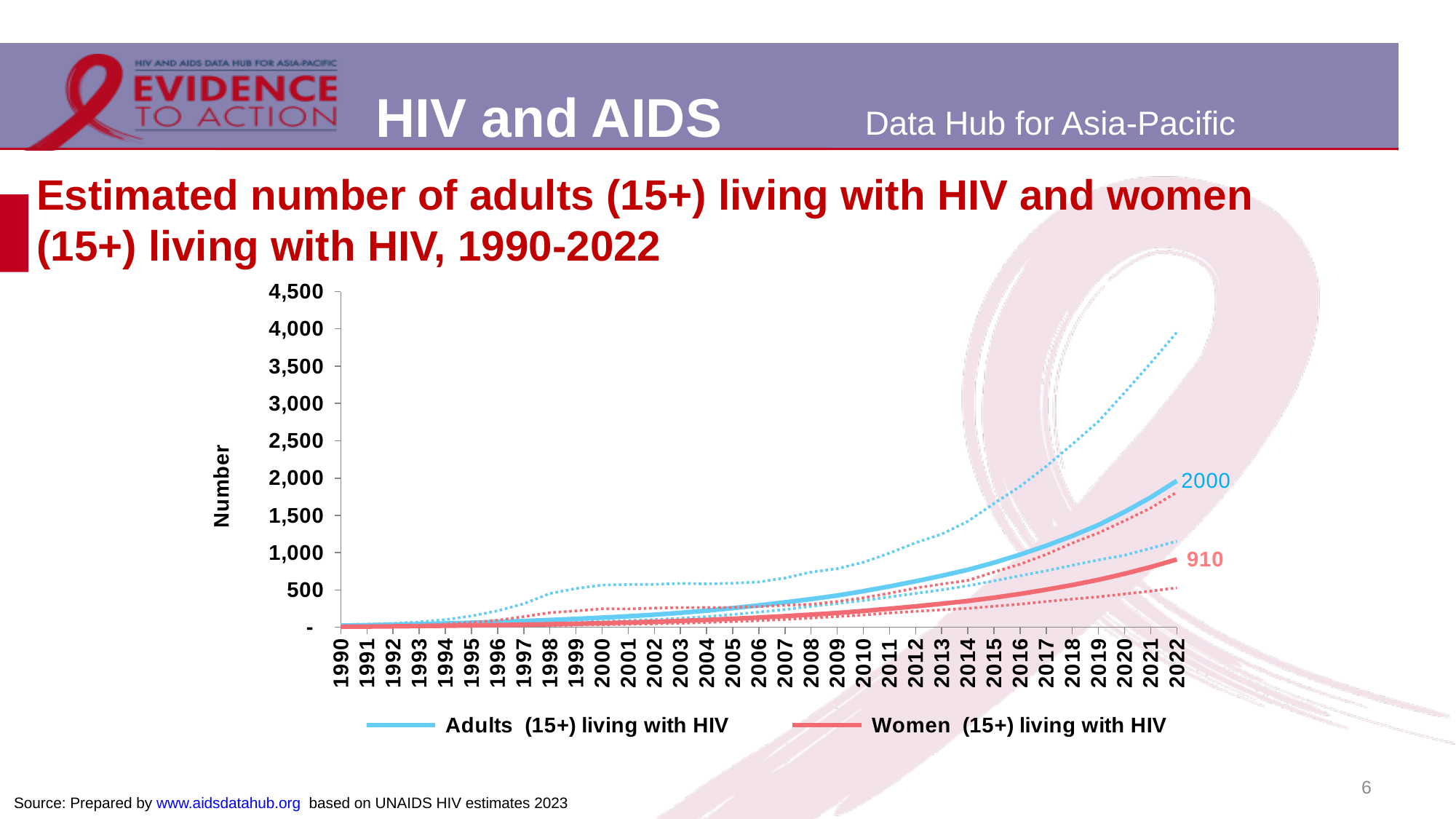
How many years are shown on the x axis? 33 What is the difference between the number of adults (15+) living with HIV and women (15+) living with HIV in 2022? 1090 In which year is the value for Adults (15+) living with HIV highest? 2022 Do the values for Adults (15+) living with HIV rise or fall from 1990 to 2022? Rise In 2022, which series has the larger value: Adults (15+) living with HIV or Women (15+) living with HIV? Adults (15+) living with HIV What is the label on the vertical axis of the chart? Number What is the estimated number of adults (15+) living with HIV in 2022? 2000 What is the estimated number of women (15+) living with HIV in 2022? 910 Is the value for Women (15+) living with HIV in 2015 greater or less than 500? less How many series does the legend list? 2 Is the value for Adults (15+) living with HIV in 2020 greater or less than 1,000? greater What kind of chart is shown on the slide? Line chart